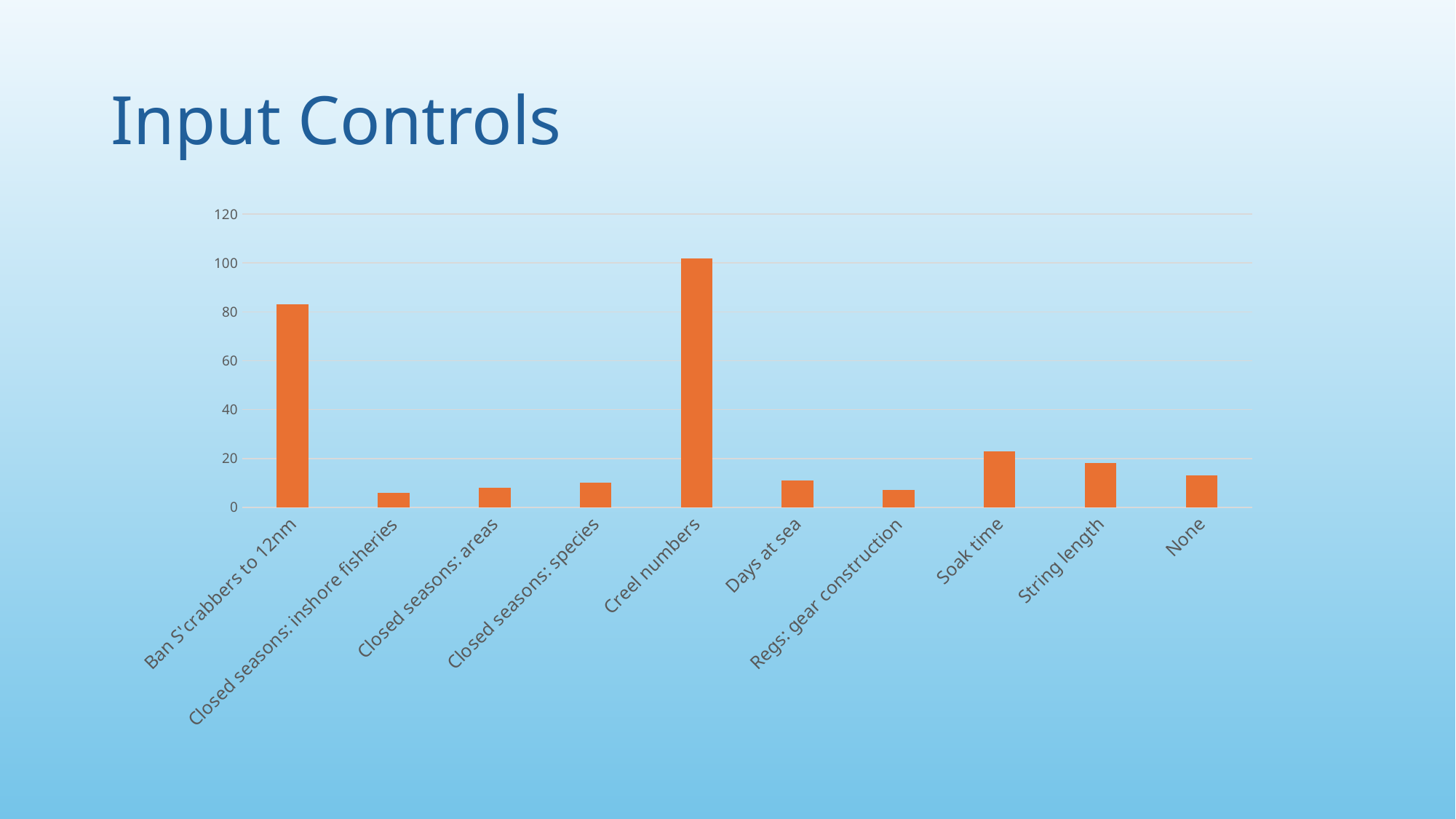
Which category has the highest value in the chart? Creel numbers Is the value for Days at sea greater or less than 20? less Which is larger, the value for Ban S'crabbers to 12nm or the value for Creel numbers? Creel numbers Is the value for Soak time greater or less than 20? greater How many categories are shown on the x axis of the chart? 10 What is the title of the slide containing the chart? Input Controls Is the value for Creel numbers greater or less than 80? greater What kind of chart is shown on the slide? Bar chart Which is larger, the value for Closed seasons: species or the value for Closed seasons: inshore fisheries? Closed seasons: species Which is larger, the value for Soak time or the value for String length? Soak time